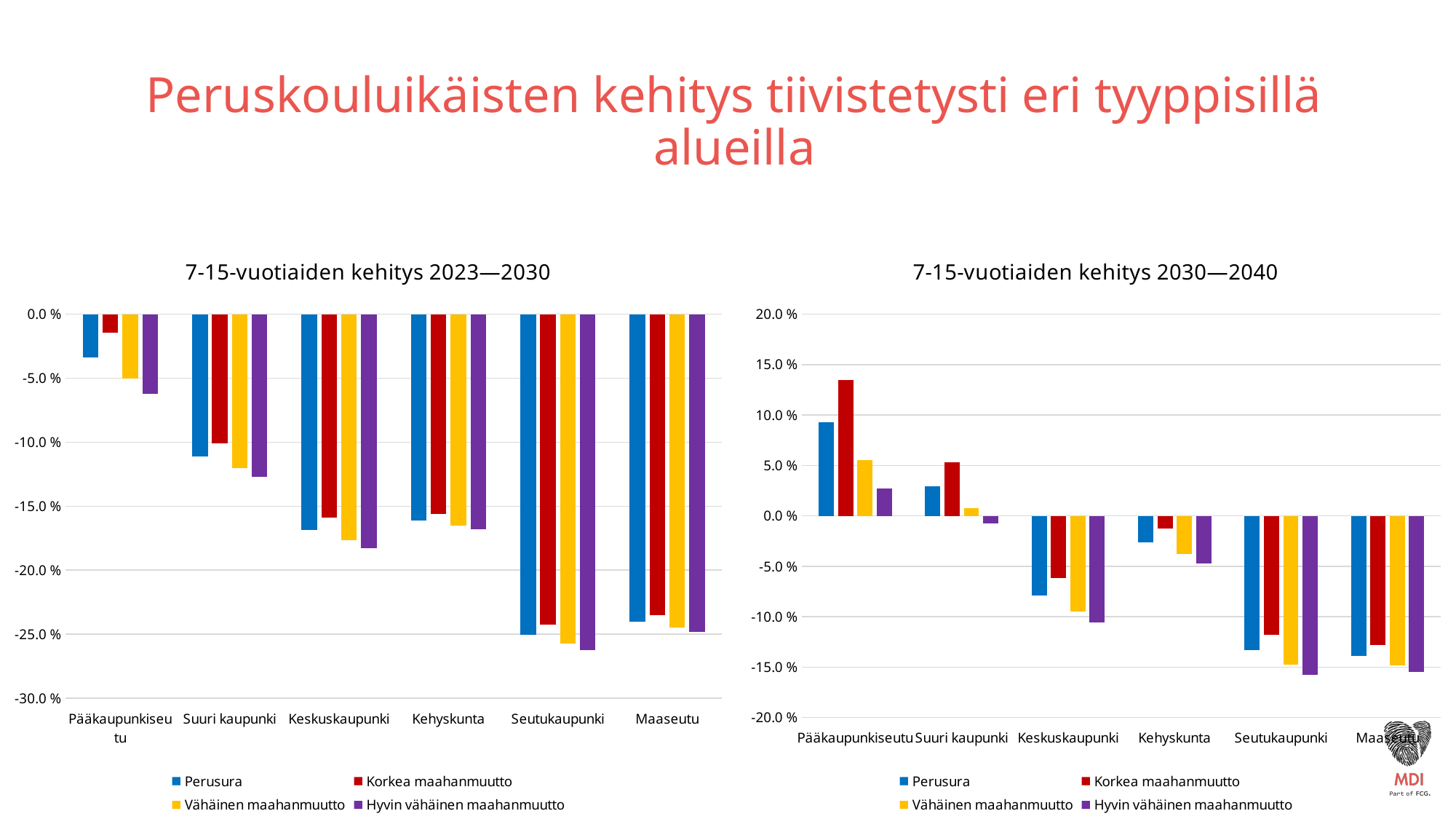
How many categories are shown on the x axis of the right chart, '7-15-vuotiaiden kehitys 2030—2040'? 6 In the left chart, '7-15-vuotiaiden kehitys 2023—2030', is the Hyvin vähäinen maahanmuutto value for Seutukaupunki greater or less than -25.0 %? less In the right chart, '7-15-vuotiaiden kehitys 2030—2040', which category has the highest Korkea maahanmuutto value? Pääkaupunkiseutu In the right chart, '7-15-vuotiaiden kehitys 2030—2040', is the Hyvin vähäinen maahanmuutto value for Seutukaupunki greater or less than -15.0 %? less In the right chart, '7-15-vuotiaiden kehitys 2030—2040', which is larger: the Perusura value for Pääkaupunkiseutu or for Suuri kaupunki? Pääkaupunkiseutu In the left chart, '7-15-vuotiaiden kehitys 2023—2030', is the Perusura value for Pääkaupunkiseutu greater or less than -5.0 %? greater What colour represents the Korkea maahanmuutto series in the legend of the right chart, '7-15-vuotiaiden kehitys 2030—2040'? red In the left chart, '7-15-vuotiaiden kehitys 2023—2030', which category has the highest Perusura value? Pääkaupunkiseutu How many series does the legend of the left chart, '7-15-vuotiaiden kehitys 2023—2030', list? 4 What type of chart is the left chart, '7-15-vuotiaiden kehitys 2023—2030'? bar chart